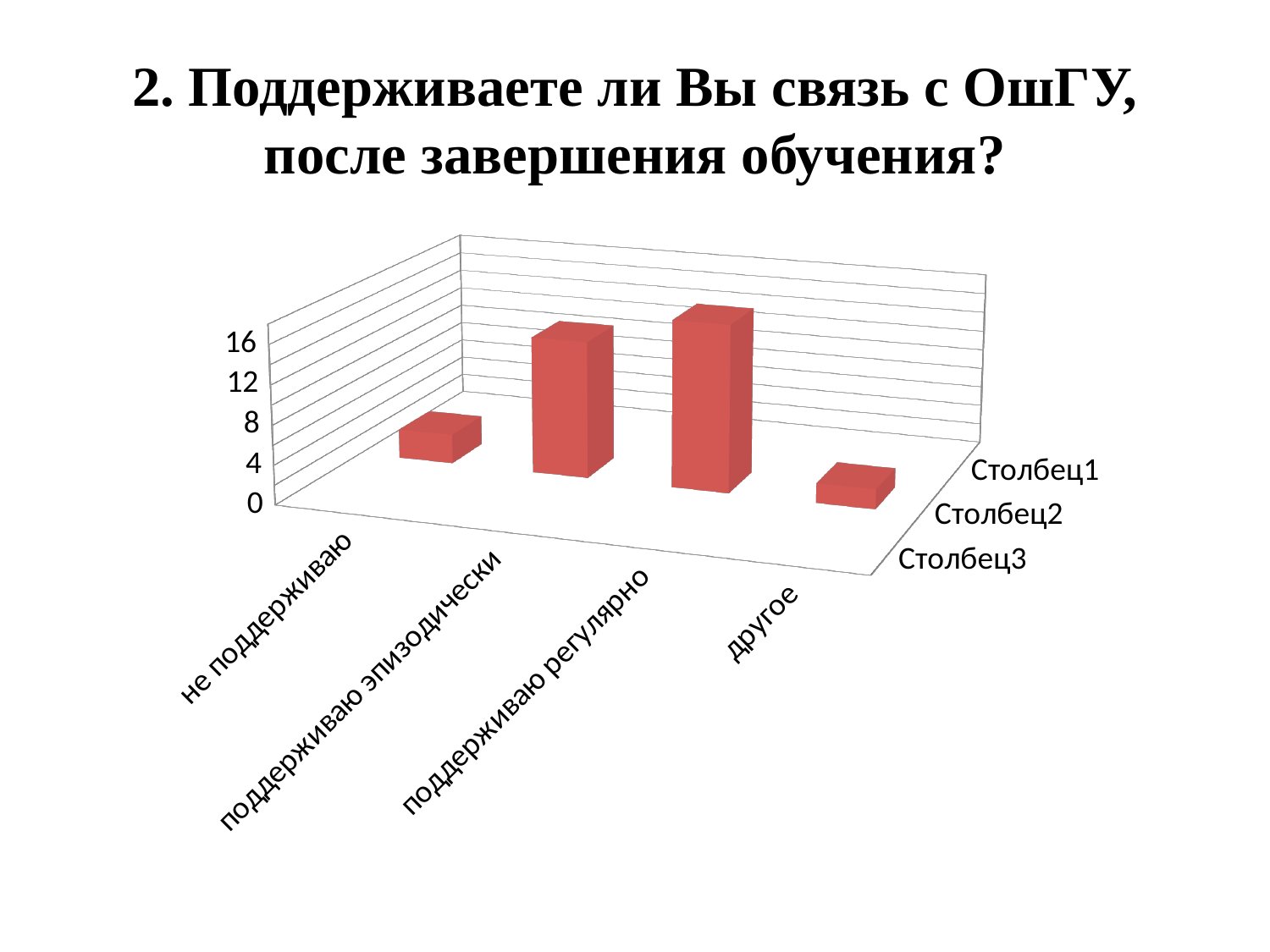
Is the value for "поддерживаю регулярно" greater or less than 8? greater What kind of chart is shown on the slide? bar chart Is the value for "поддерживаю эпизодически" greater or less than 8? greater Which category has the lowest bar? другое Which is larger, the value for "другое" or the value for "поддерживаю регулярно"? поддерживаю регулярно What colour are the bars in the chart? red Is the value for "не поддерживаю" greater or less than 12? less Which category has the highest bar? поддерживаю регулярно What is the title of the slide above the chart? 2. Поддерживаете ли Вы связь с ОшГУ, после завершения обучения? How many categories are shown on the chart's category axis? 4 Which is larger, the value for "не поддерживаю" or the value for "поддерживаю эпизодически"? поддерживаю эпизодически